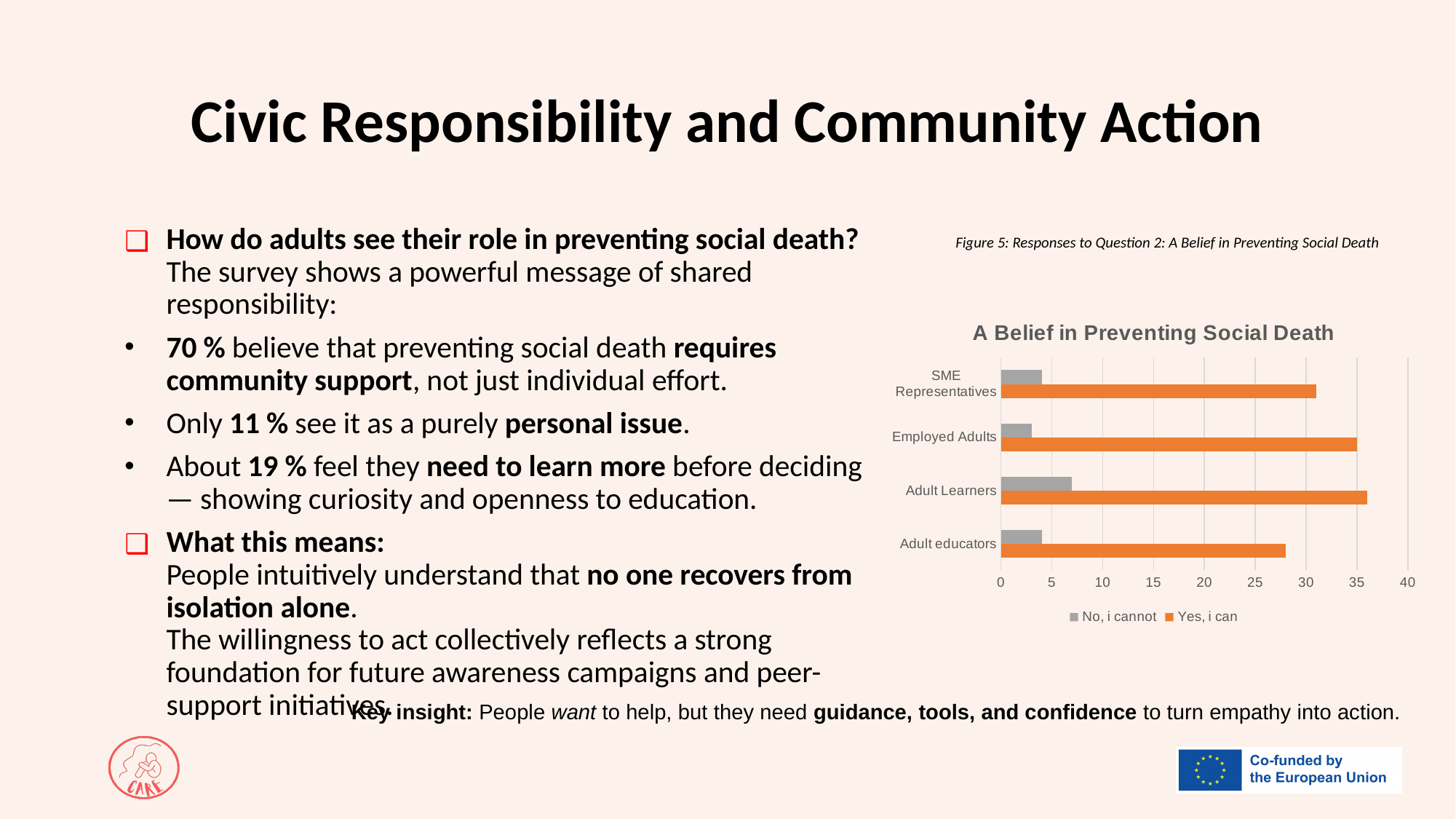
Which category has the highest value for the "No, i cannot" series? Adult Learners What is the title of the chart? A Belief in Preventing Social Death Which category has the lowest value for the "Yes, i can" series? Adult educators What kind of chart is shown on the slide? Bar chart How many series does the chart's legend list? 2 Is the "Yes, i can" value for Adult educators greater or less than 30? less Which is larger: the "Yes, i can" value for Employed Adults or for Adult educators? Employed Adults How many categories are shown on the chart's vertical axis? 4 Is the "Yes, i can" value for Employed Adults greater or less than 30? greater What are the two series named in the chart's legend? No, i cannot; Yes, i can Is the "No, i cannot" value for Adult Learners greater or less than 5? greater Which is larger: the "No, i cannot" value for Adult Learners or for SME Representatives? Adult Learners